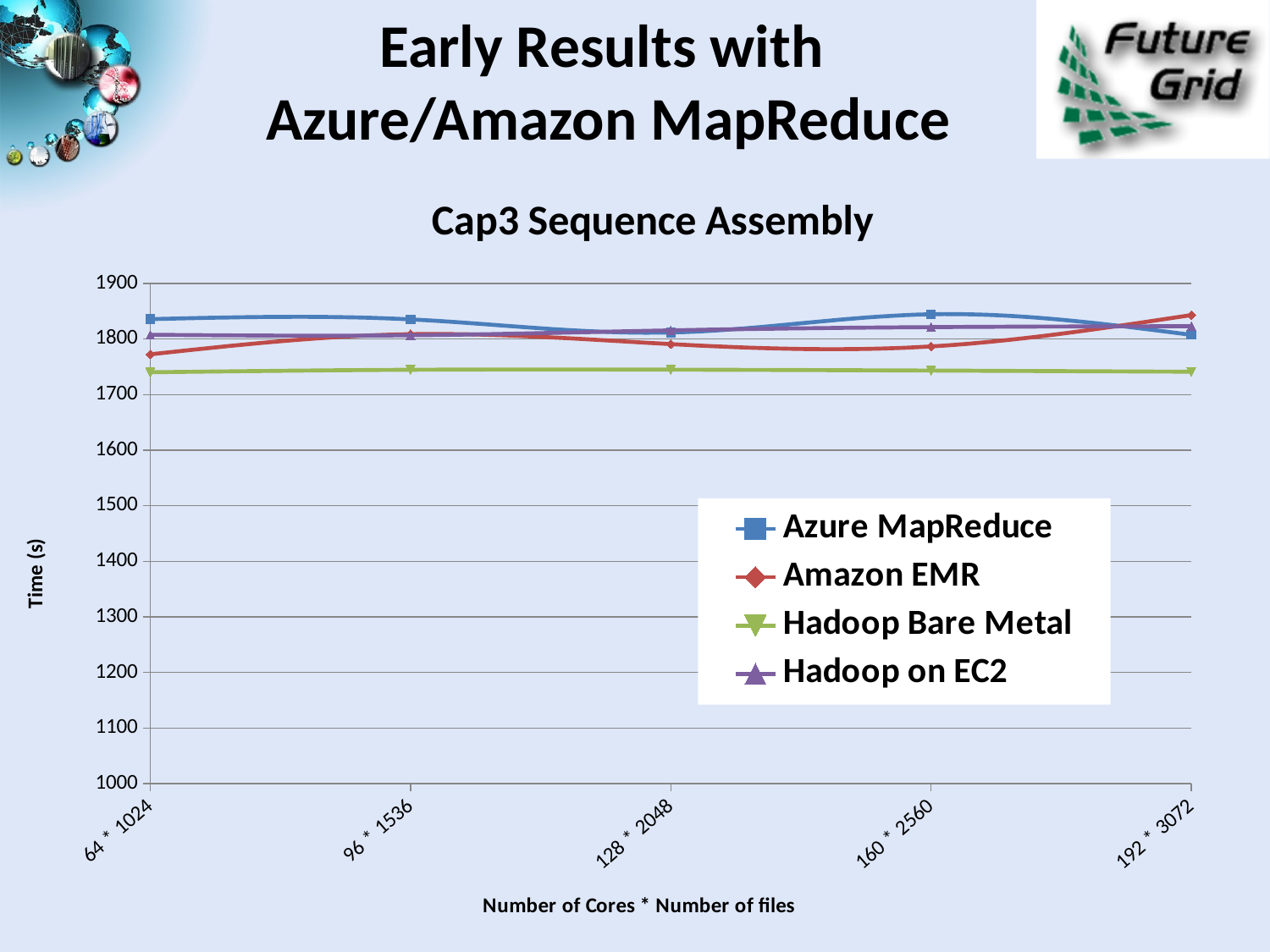
Is the value for Azure MapReduce at 64 * 1024 greater or less than 1800? greater Is the value for Hadoop Bare Metal at 64 * 1024 greater or less than 1800? less How many series does the legend list? 4 What is the label of the y axis? Time (s) At 64 * 1024, which is larger: Azure MapReduce or Amazon EMR? Azure MapReduce How many categories are shown on the x axis? 5 Is the value for Amazon EMR at 64 * 1024 greater or less than 1800? less Which series has the lowest time at 64 * 1024? Hadoop Bare Metal At 192 * 3072, which is larger: Amazon EMR or Hadoop Bare Metal? Amazon EMR What type of chart is shown on the slide? line chart Which series has the lowest time at 192 * 3072? Hadoop Bare Metal What is the title of the chart? Cap3 Sequence Assembly